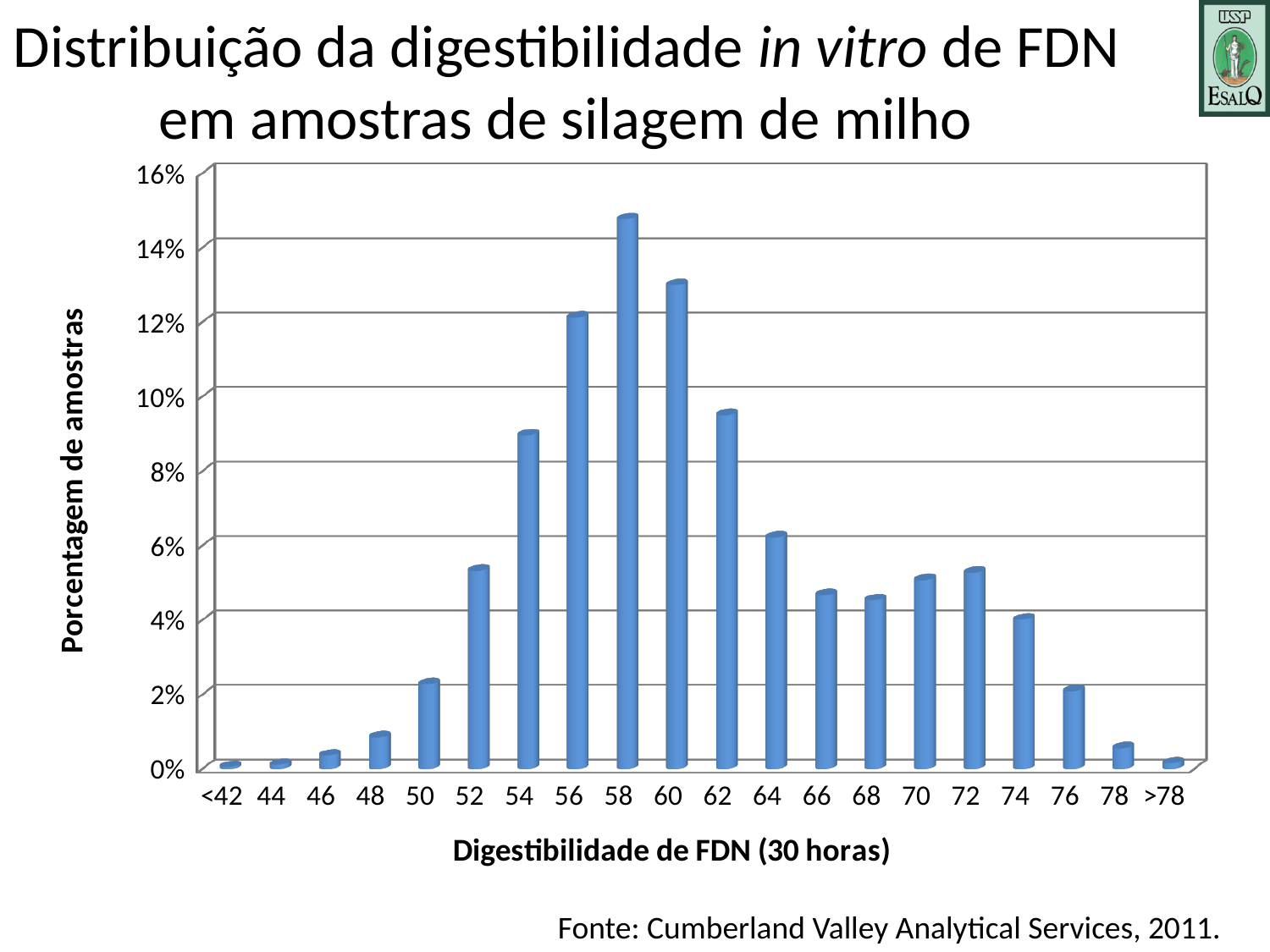
Which has a larger value, category 72 or category 74? 72 What kind of chart is shown on the slide? bar chart How many categories are shown on the x axis of the chart? 20 Is the value for category 56 greater or less than 10%? greater What is the title of the y axis of the chart? Porcentagem de amostras Is the value for category 74 greater or less than 6%? less Do the values rise or fall along the x axis from <42 to 58? rise Which digestibility category has the highest percentage of samples? 58 Which has a larger value, category 58 or category 60? 58 Is the value for category 50 greater or less than 4%? less